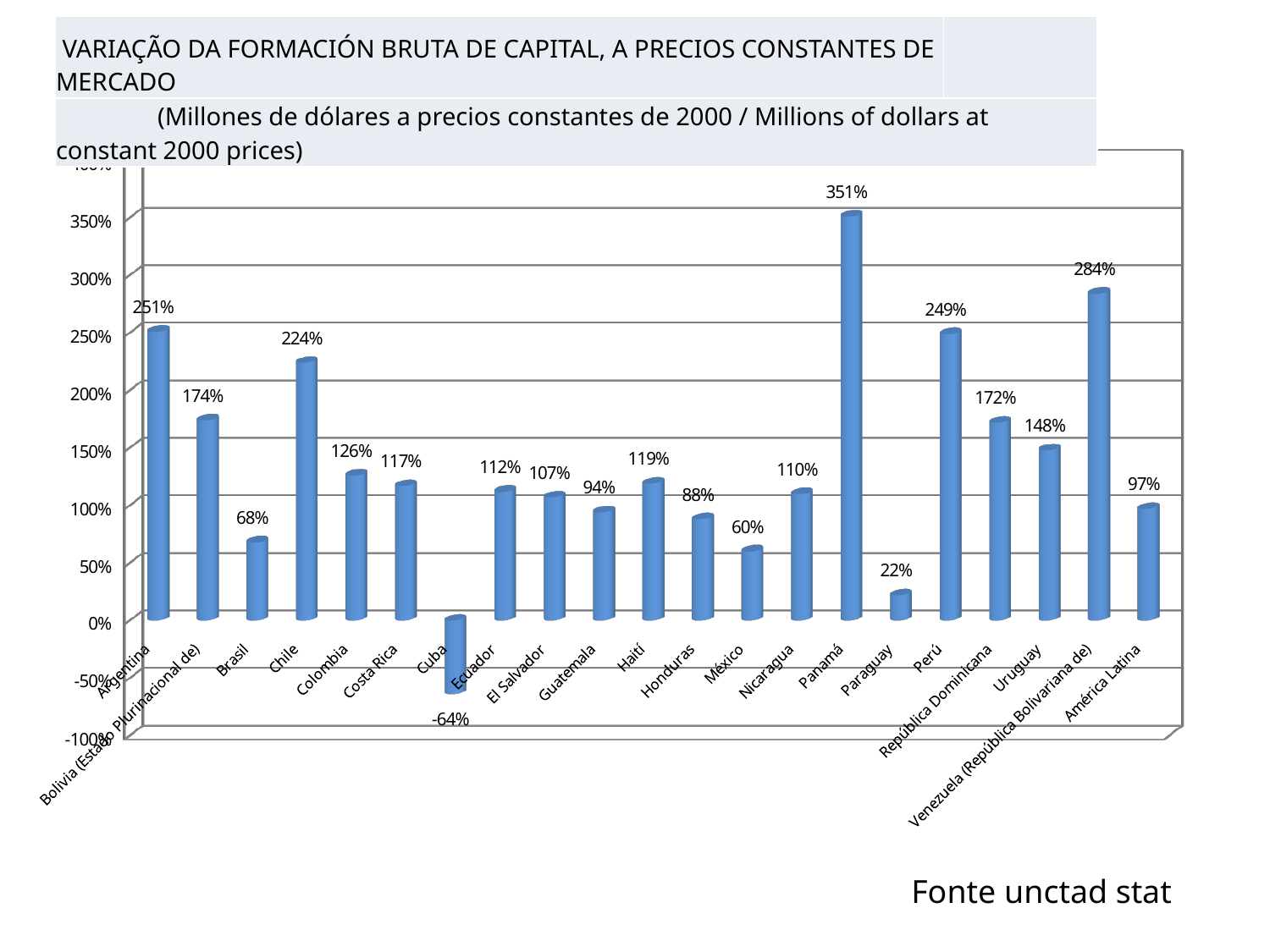
What is the value shown for Panamá? 351% What source is cited for the chart at the bottom of the slide? Fonte unctad stat What kind of chart is shown on the slide? Bar chart What is the value shown for Paraguay? 22% Which country has the highest value in the chart? Panamá Which has a larger value, Chile or Bolivia (Estado Plurinacional de)? Chile What is the value shown for Cuba? -64% Which country has the lowest value in the chart? Cuba What is the difference between the values for Argentina and Brasil? 183 percentage points What is the difference between the values for Venezuela (República Bolivariana de) and Perú? 35 percentage points How many countries or regions are plotted in the chart? 21 What is the value shown for América Latina? 97%